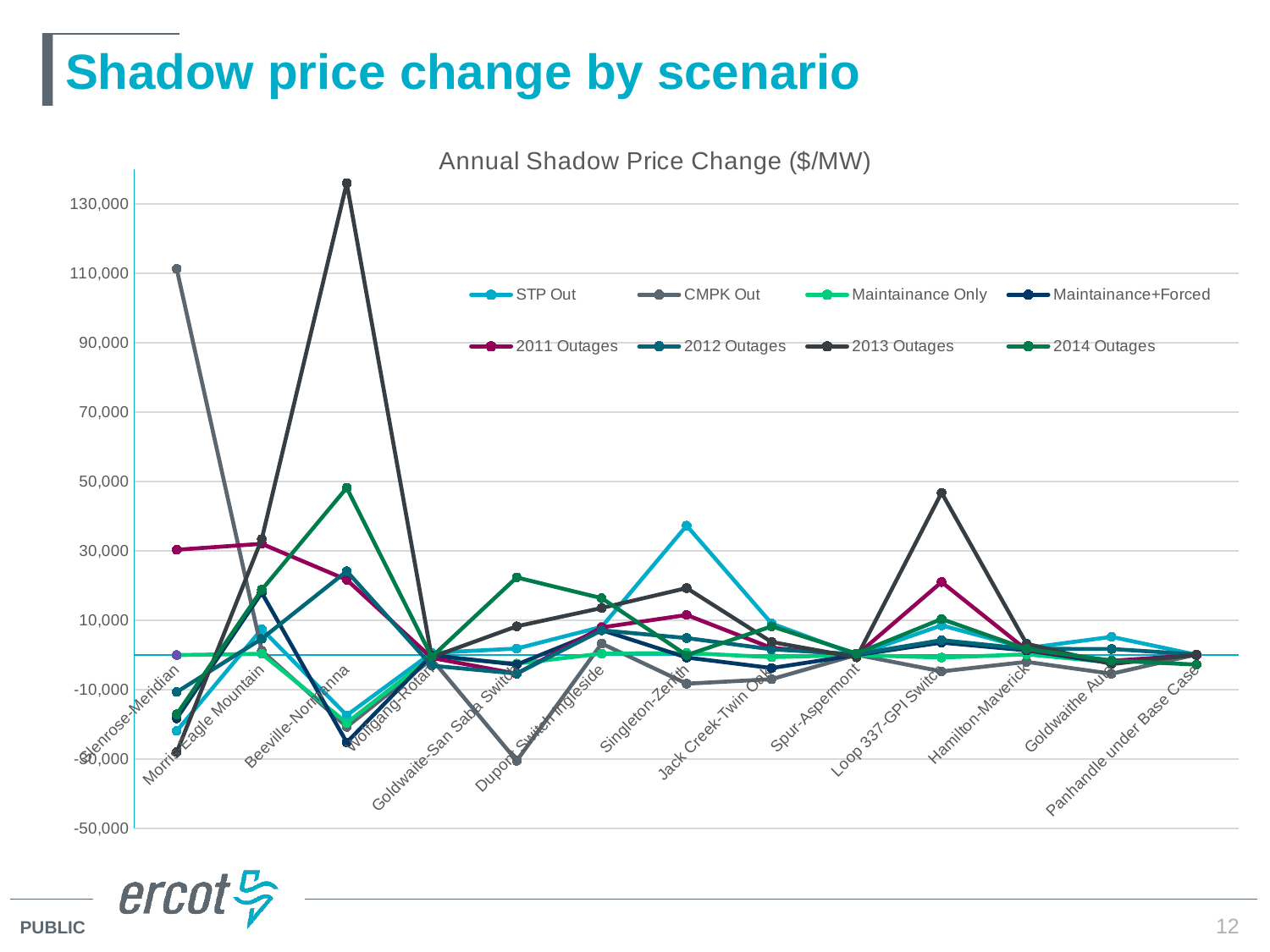
Is the value for 2013 Outages at Beeville-Normanna greater or less than 130,000? greater For the STP Out series, which category has the highest value? Singleton-Zenith Is the value for 2013 Outages at Loop 337-GPI Switch greater or less than 50,000? less Is the value for CMPK Out at Glenrose-Meridian greater or less than 90,000? greater At Glenrose-Meridian, which is larger: the CMPK Out value or the 2011 Outages value? CMPK Out What is the title of the chart? Annual Shadow Price Change ($/MW) For the 2013 Outages series, which category has the highest value? Beeville-Normanna What kind of chart is shown on the slide? line chart How many categories are plotted along the x axis of the chart? 13 How many series does the chart's legend list? 8